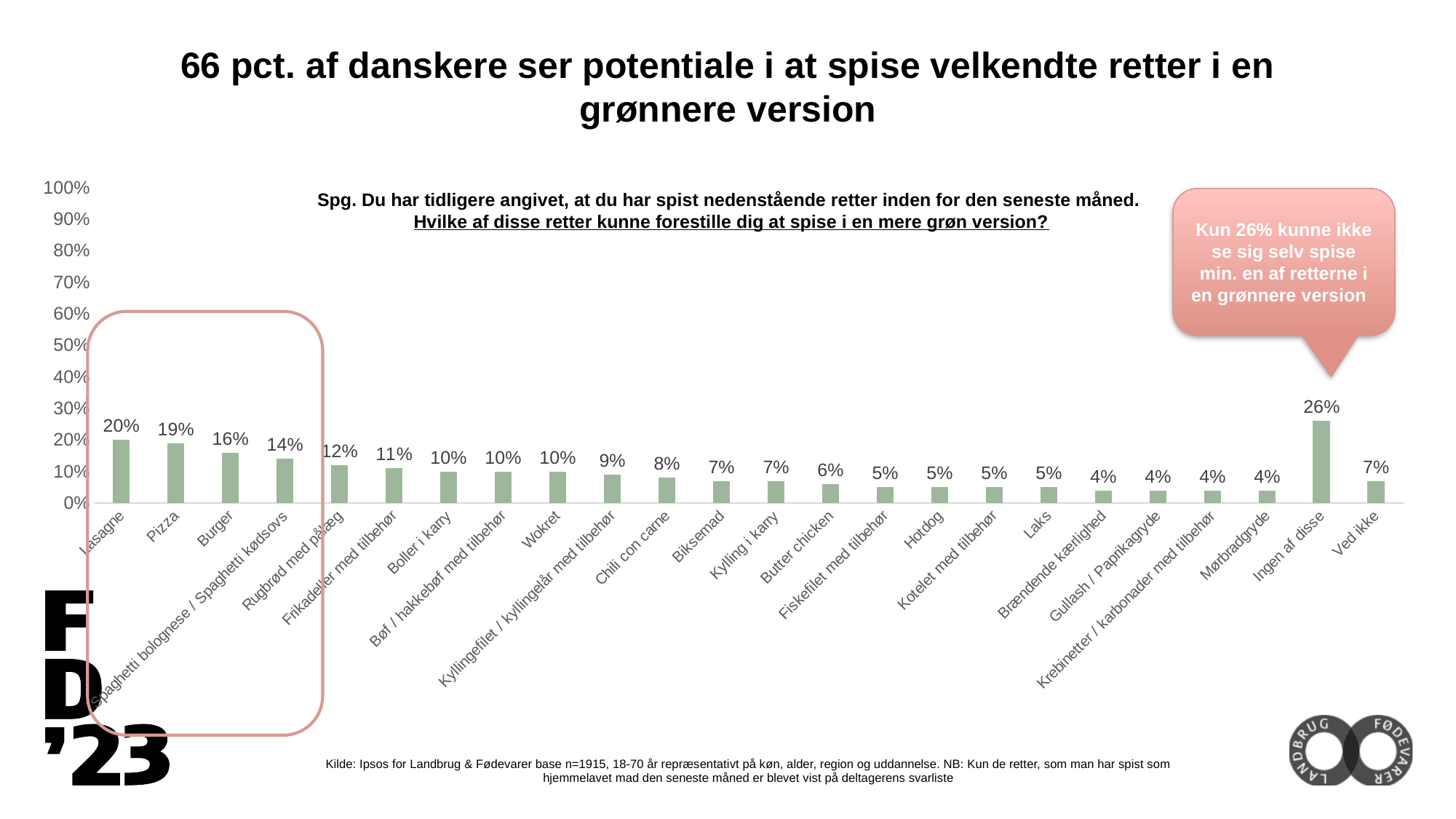
What is the value for Rugbrød med pålæg? 12% What kind of chart is shown on the slide? bar chart What is the value for Ved ikke? 7% What is the value for Butter chicken? 6% What is the difference between the values for Lasagne and Burger? 4% What is the difference between the values for Ingen af disse and Lasagne? 6% What is the value for Lasagne? 20% Which category has the highest value in the chart? Ingen af disse What is the value for Pizza? 19% Which has a larger value, Chili con carne or Hotdog? Chili con carne How many categories are shown on the x axis of the chart? 24 Is the value for Ingen af disse greater or less than 20%? greater